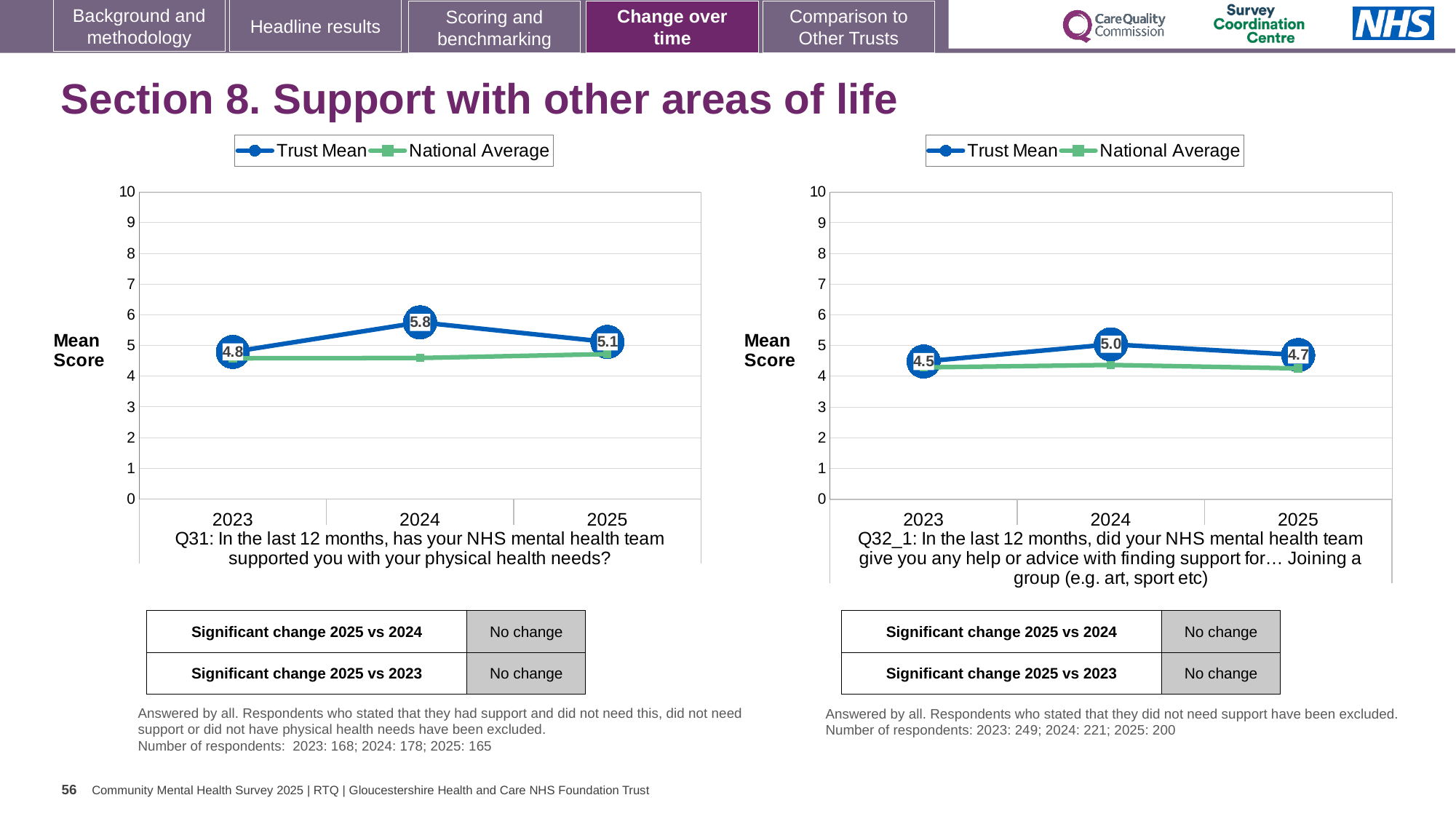
On the right chart (Q32_1), what is the Trust Mean score for 2025? 4.7 On the left chart (Q31), what is the Trust Mean score for 2024? 5.8 On the right chart (Q32_1), is the National Average value for 2024 greater or less than 5? less What type of chart is used for Q32_1 on the right? Line chart On the right chart (Q32_1), which year has the highest Trust Mean score? 2024 On the left chart (Q31), what is the Trust Mean score for 2023? 4.8 On the left chart (Q31), which year has the lowest Trust Mean score? 2023 How many series does the legend of the left chart (Q31) list? 2 On the left chart (Q31), what is the difference between the Trust Mean scores for 2024 and 2025? 0.7 How many years are plotted on the x axis of the left chart (Q31)? 3 On the left chart (Q31), is the Trust Mean for 2025 higher or lower than the Trust Mean for 2023? higher On the right chart (Q32_1), what is the difference between the Trust Mean scores for 2024 and 2023? 0.5